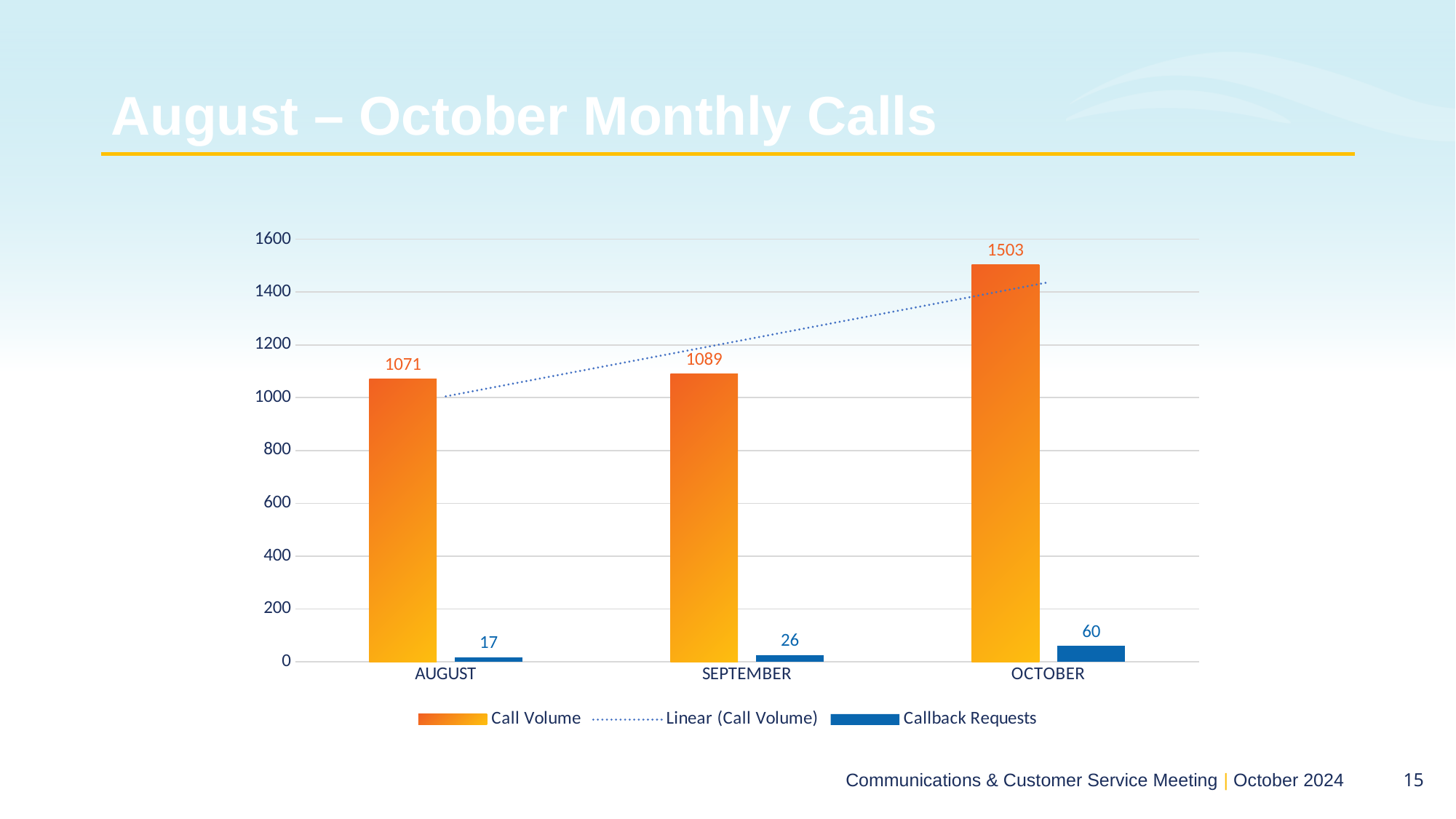
What is the Call Volume for October? 1503 Does the Call Volume rise or fall from August to October? rise Which month has the lowest Callback Requests? August What is the difference in Callback Requests between October and August? 43 Which month has the highest Call Volume? October What is the difference in Call Volume between October and September? 414 How many entries does the legend list? 3 How many months are shown on the x axis? 3 Is the Call Volume for October greater or less than 1400? greater What is the Call Volume for August? 1071 What is the Callback Requests value for September? 26 Which is larger, the Call Volume for August or for September? September